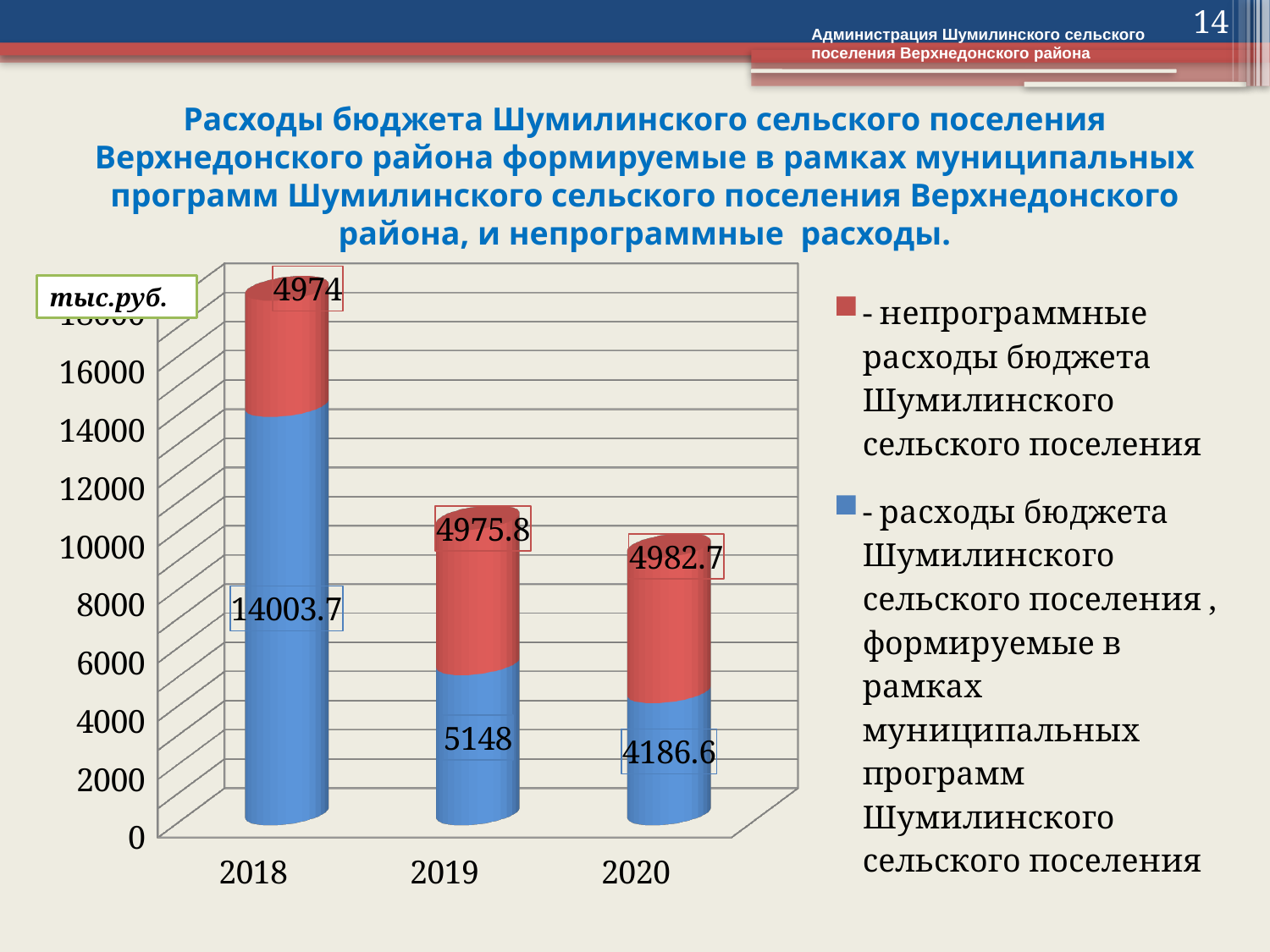
Which is larger: the program expenses (blue series) in 2019 or in 2020? 2019 In which year is the program expenses (blue series) value the lowest? 2020 What is the total height of the stacked bar for 2019? 10123.8 What type of chart is shown on the slide? stacked bar chart In which year is the program expenses (blue series) value the highest? 2018 How do the program expenses (blue series) change from 2018 to 2020? they fall What is the value of the program expenses (blue series) for 2020? 4186.6 What is the value of the program expenses (blue series, расходы бюджета, формируемые в рамках муниципальных программ) for 2018? 14003.7 What is the difference between the program expenses (blue series) in 2018 and 2019? 8855.7 How many years (categories) are shown on the x axis of the chart? 3 What is the value of the non-program expenses (red series, непрограммные расходы) for 2019? 4975.8 How many series does the chart legend list? 2